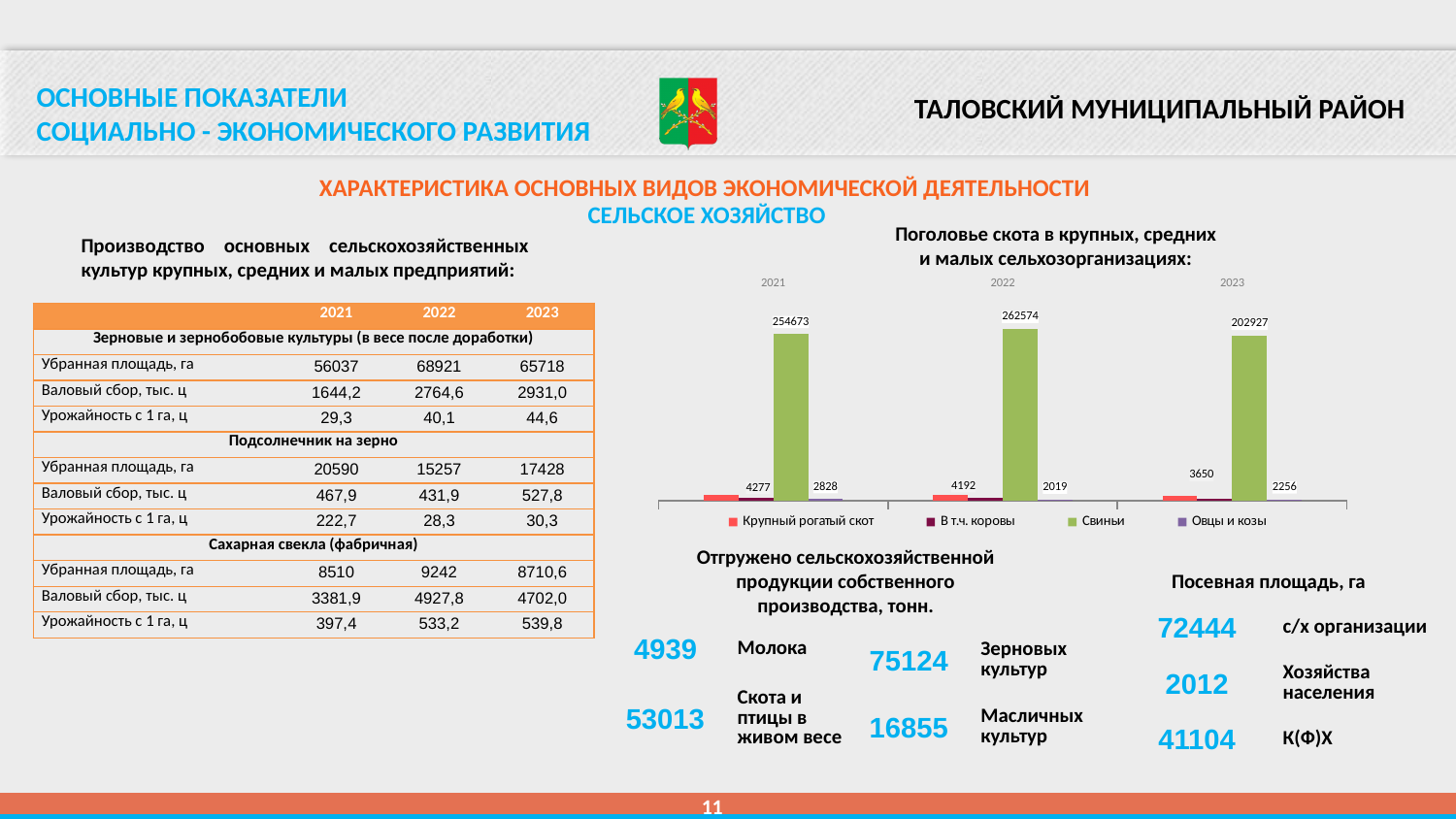
In the livestock chart, which series is shown in green? Свиньи In the livestock chart, what is the difference between the Свиньи values for 2022 and 2023? 59647 What kind of chart is used to show the livestock headcount (Поголовье скота)? bar chart In the livestock chart, which is larger: Овцы и козы in 2021 or Овцы и козы in 2022? 2021 In the livestock chart, what is the value for Свиньи in 2022? 262574 In the livestock chart, what is the value for Овцы и козы in 2023? 2256 How many series does the legend of the livestock chart list? 4 In the livestock chart, which year has the highest value for Свиньи? 2022 In the livestock chart, what is the value for Свиньи in 2023? 202927 How many years are shown on the x axis of the livestock chart? 3